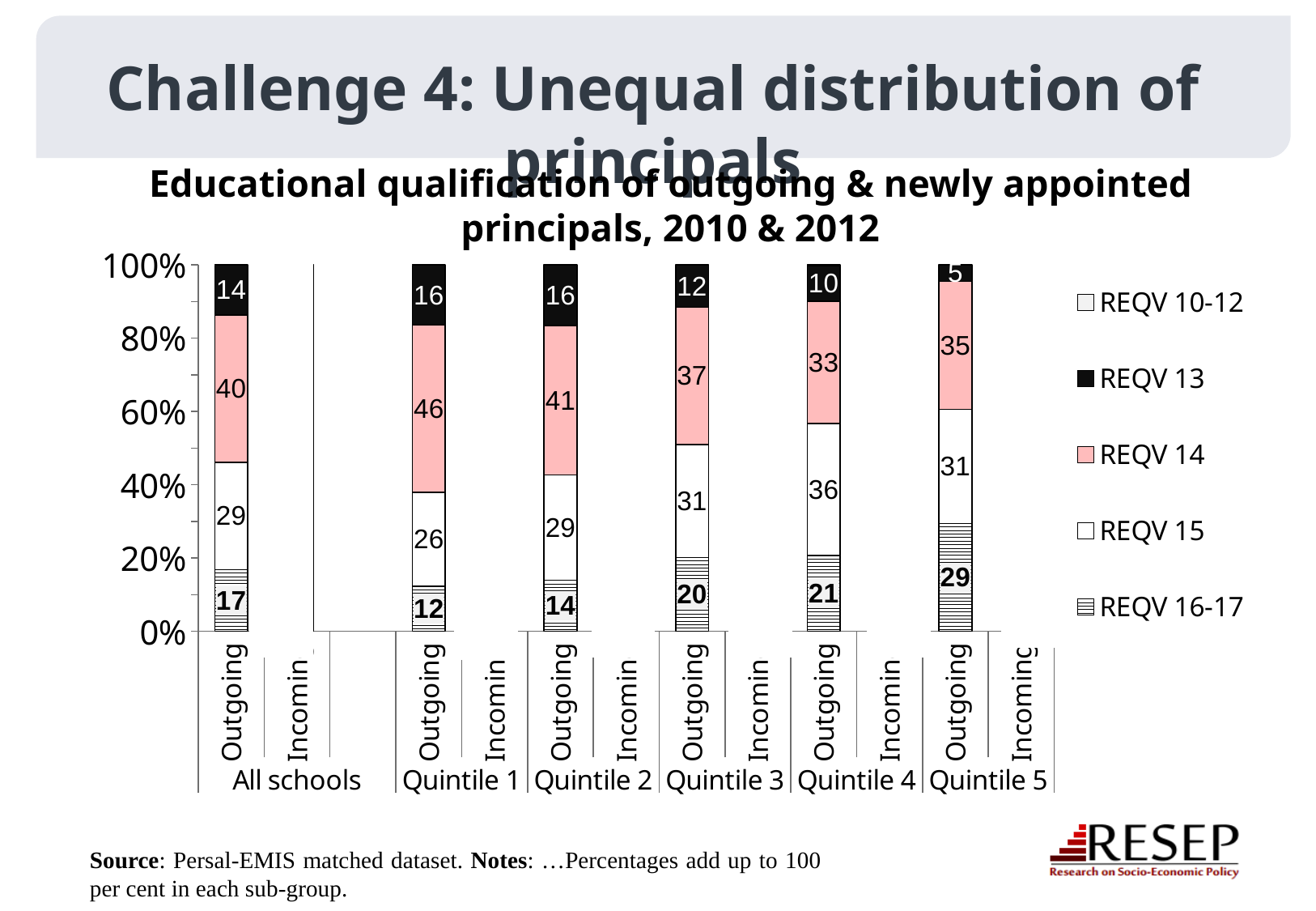
Which quintile has the highest REQV 14 value for Outgoing principals? Quintile 1 For Outgoing principals in Quintile 3, which is larger: the REQV 14 value or the REQV 15 value? REQV 14 What is the difference between the REQV 16-17 values for Outgoing principals in Quintile 5 and Quintile 1? 17 What is the title of the chart? Educational qualification of outgoing & newly appointed principals, 2010 & 2012 What is the REQV 15 value for Outgoing principals in Quintile 4? 36 Which quintile has the lowest REQV 13 value for Outgoing principals? Quintile 5 What is the REQV 13 value for Outgoing principals in All schools? 14 What kind of chart is shown on the slide? Stacked bar chart What is the REQV 16-17 value for Outgoing principals in Quintile 5? 29 What is the REQV 14 value for Outgoing principals in Quintile 1? 46 Does the REQV 16-17 value for Outgoing principals increase or decrease from Quintile 1 to Quintile 5? Increase How many series does the legend list? 5